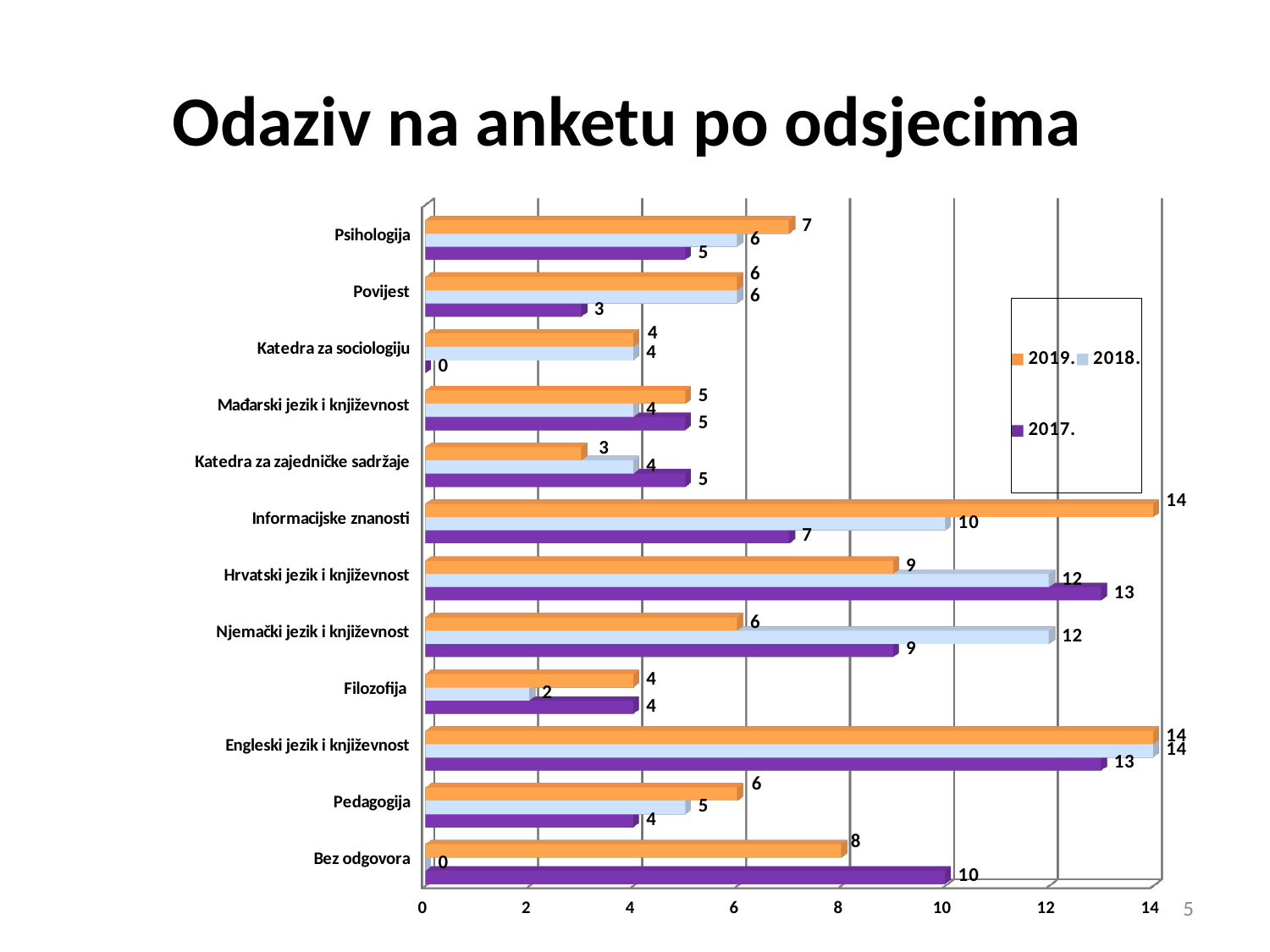
What is the difference between the 2019. and 2017. values for Informacijske znanosti? 7 What is the value for Filozofija in the 2018. series? 2 How many categories are shown on the chart? 12 Which category has the lowest value in the 2017. series? Katedra za sociologiju Which is larger for Bez odgovora: the 2019. value or the 2017. value? 2017. What is the difference between the 2018. and 2019. values for Njemački jezik i književnost? 6 What is the value for Informacijske znanosti in the 2019. series? 14 What is the title of the slide? Odaziv na anketu po odsjecima Which category has the highest value in the 2018. series? Engleski jezik i književnost What kind of chart is shown on the slide? Bar chart How many series does the legend list? 3 What is the value for Hrvatski jezik i književnost in the 2017. series? 13